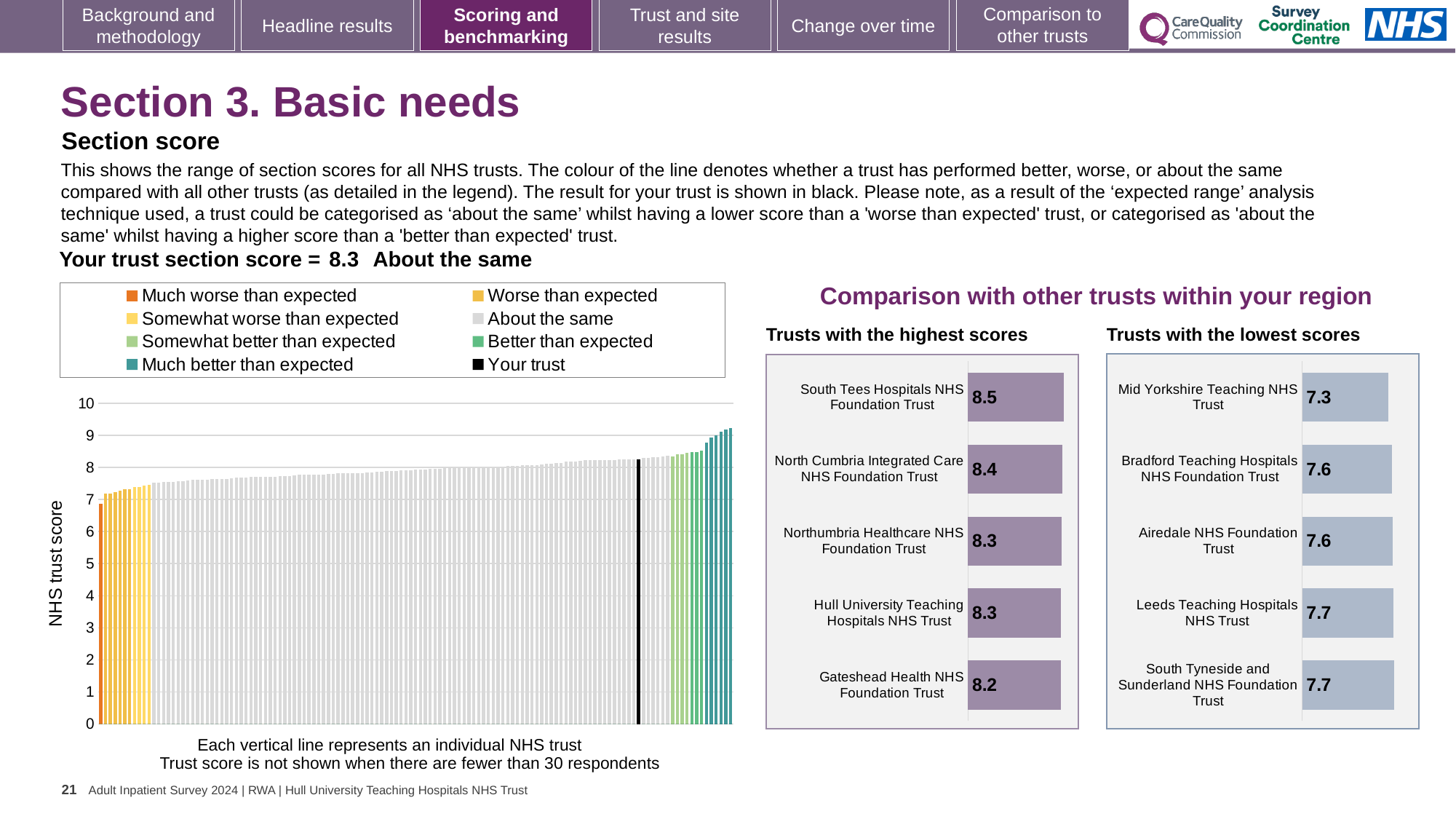
In the large chart on the left, is the value of the tallest bar greater or less than 9? greater In the 'Trusts with the lowest scores' chart, what is the score for Airedale NHS Foundation Trust? 7.6 How many entries does the legend above the large chart on the left list? 8 In the large chart on the left, what is the label on the vertical axis? NHS trust score In the large chart on the left, do the bar values rise or fall from left to right? rise What type of chart is the large chart on the left showing the range of section scores? Bar chart In the 'Trusts with the lowest scores' chart, which trust has the lowest score? Mid Yorkshire Teaching NHS Trust In the 'Trusts with the highest scores' chart, what is the difference between the scores of South Tees Hospitals NHS Foundation Trust and Gateshead Health NHS Foundation Trust? 0.3 In the 'Trusts with the lowest scores' chart, which has the larger score: Bradford Teaching Hospitals NHS Foundation Trust or Leeds Teaching Hospitals NHS Trust? Leeds Teaching Hospitals NHS Trust In the 'Trusts with the highest scores' chart, what is the score for South Tees Hospitals NHS Foundation Trust? 8.5 In the large chart on the left, is the value of the black bar (your trust) greater or less than 8? greater In the 'Trusts with the highest scores' chart, how many trusts are shown? 5